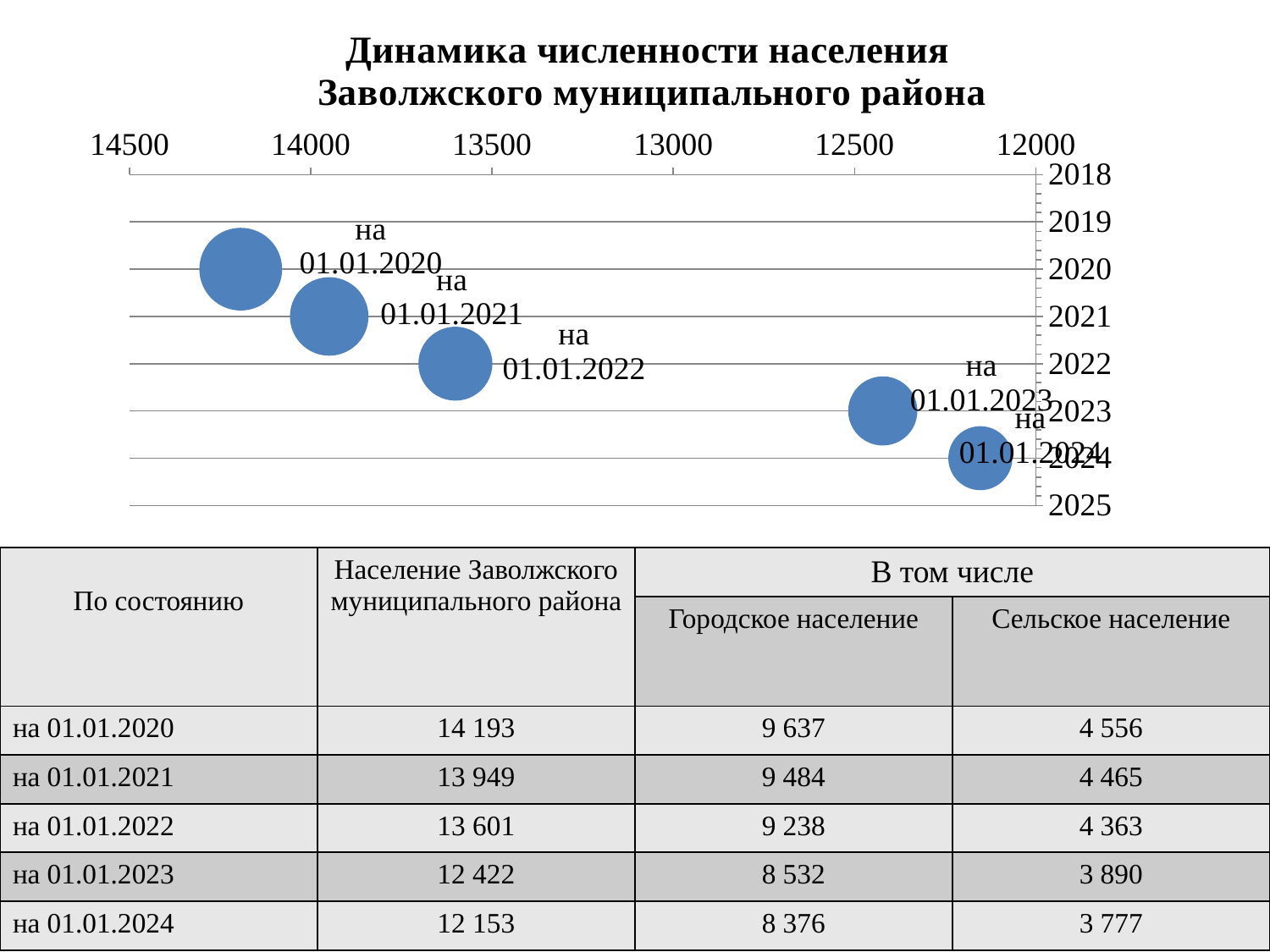
Do the population values rise or fall from 01.01.2020 to 01.01.2024? fall According to the table on the slide, what is the population of the Zavolzhsky municipal district on 01.01.2022? 13 601 What kind of chart is shown on the slide? bubble chart Which is larger, the value for на 01.01.2021 or the value for на 01.01.2023? на 01.01.2021 According to the table on the slide, what is the difference between the district population on 01.01.2020 and on 01.01.2024? 2 040 Is the value for на 01.01.2020 greater or less than 14000? greater Which date has the lowest population value on the chart? на 01.01.2024 Which date has the highest population value on the chart? на 01.01.2020 Is the value for на 01.01.2023 greater or less than 12500? less What is the title of the chart? Динамика численности населения Заволжского муниципального района How many data points (bubbles) are plotted on the chart? 5 Is the value for на 01.01.2022 greater or less than 13500? greater